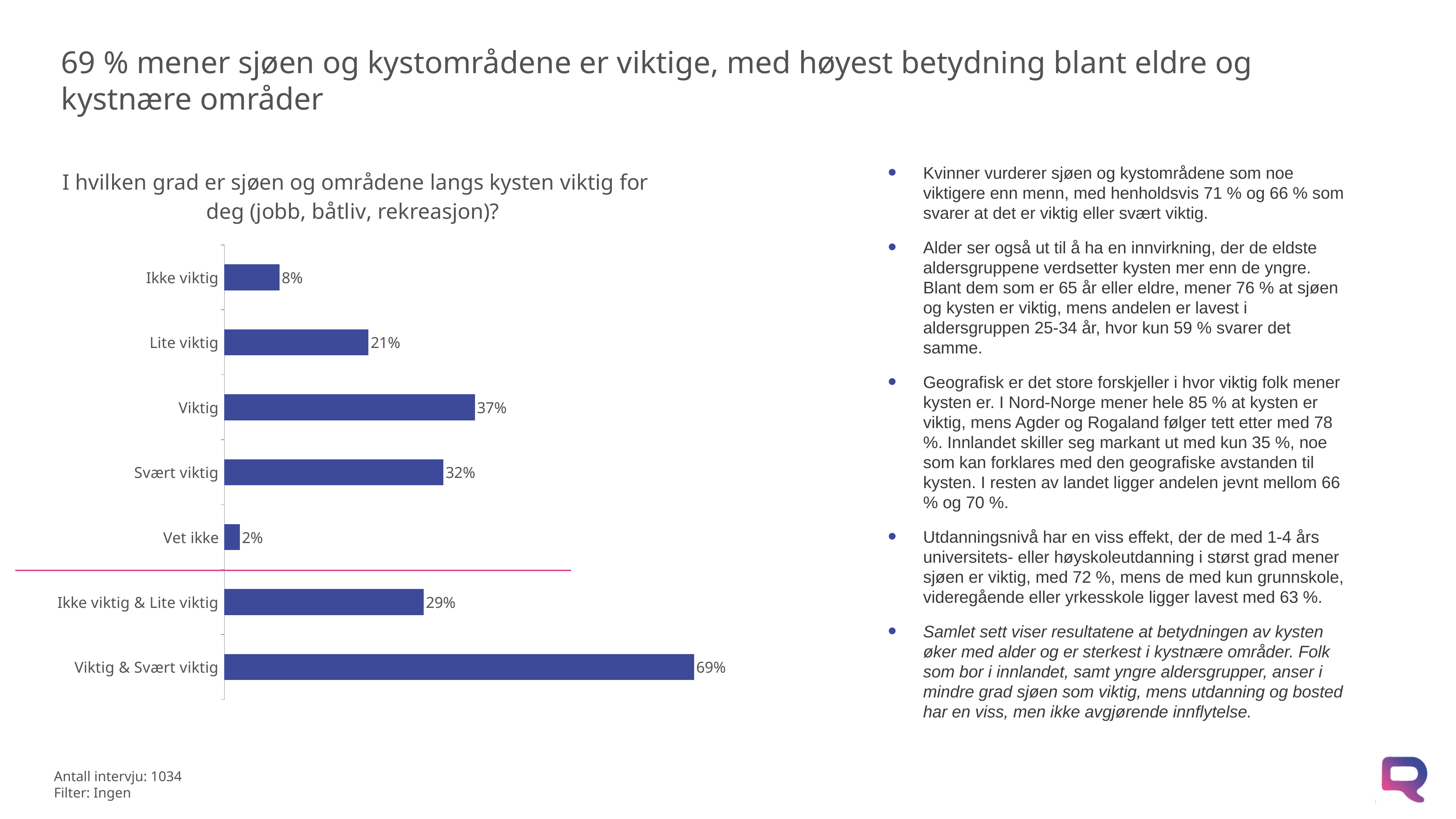
Which is larger, "Lite viktig" or "Ikke viktig"? Lite viktig What kind of chart is shown? Bar chart How many categories are shown in the chart? 7 What is the value for "Svært viktig"? 32% What is the value for "Vet ikke"? 2% What is the difference between "Lite viktig" and "Ikke viktig"? 13% Which category has the highest value? Viktig & Svært viktig What is the difference between "Viktig" and "Svært viktig"? 5% What is the value for "Ikke viktig & Lite viktig"? 29% Which category has the lowest value? Vet ikke What is the value for "Viktig"? 37% What is the title of the chart? I hvilken grad er sjøen og områdene langs kysten viktig for deg (jobb, båtliv, rekreasjon)?